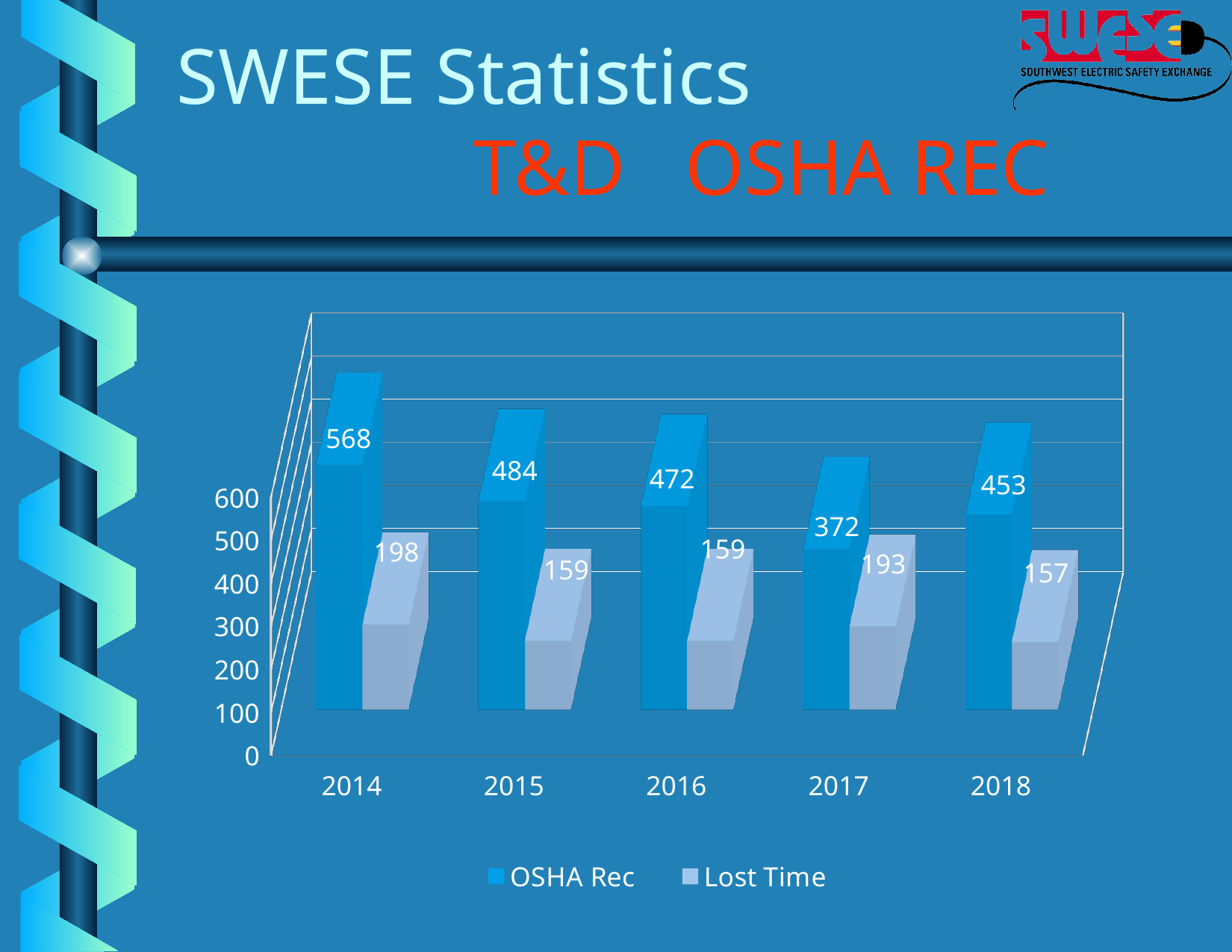
What is the OSHA Rec value for 2014? 568 How many years are shown on the x axis? 5 What kind of chart is shown on the slide? Bar chart What is the Lost Time value for 2017? 193 Which year has the highest OSHA Rec value? 2014 What is the difference between the OSHA Rec values for 2014 and 2015? 84 What is the difference between the OSHA Rec and Lost Time values for 2017? 179 Which year has the lowest Lost Time value? 2018 Which year has the lowest OSHA Rec value? 2017 How many series does the legend list? 2 What is the OSHA Rec value for 2018? 453 Which is larger, the Lost Time value for 2014 or for 2016? 2014